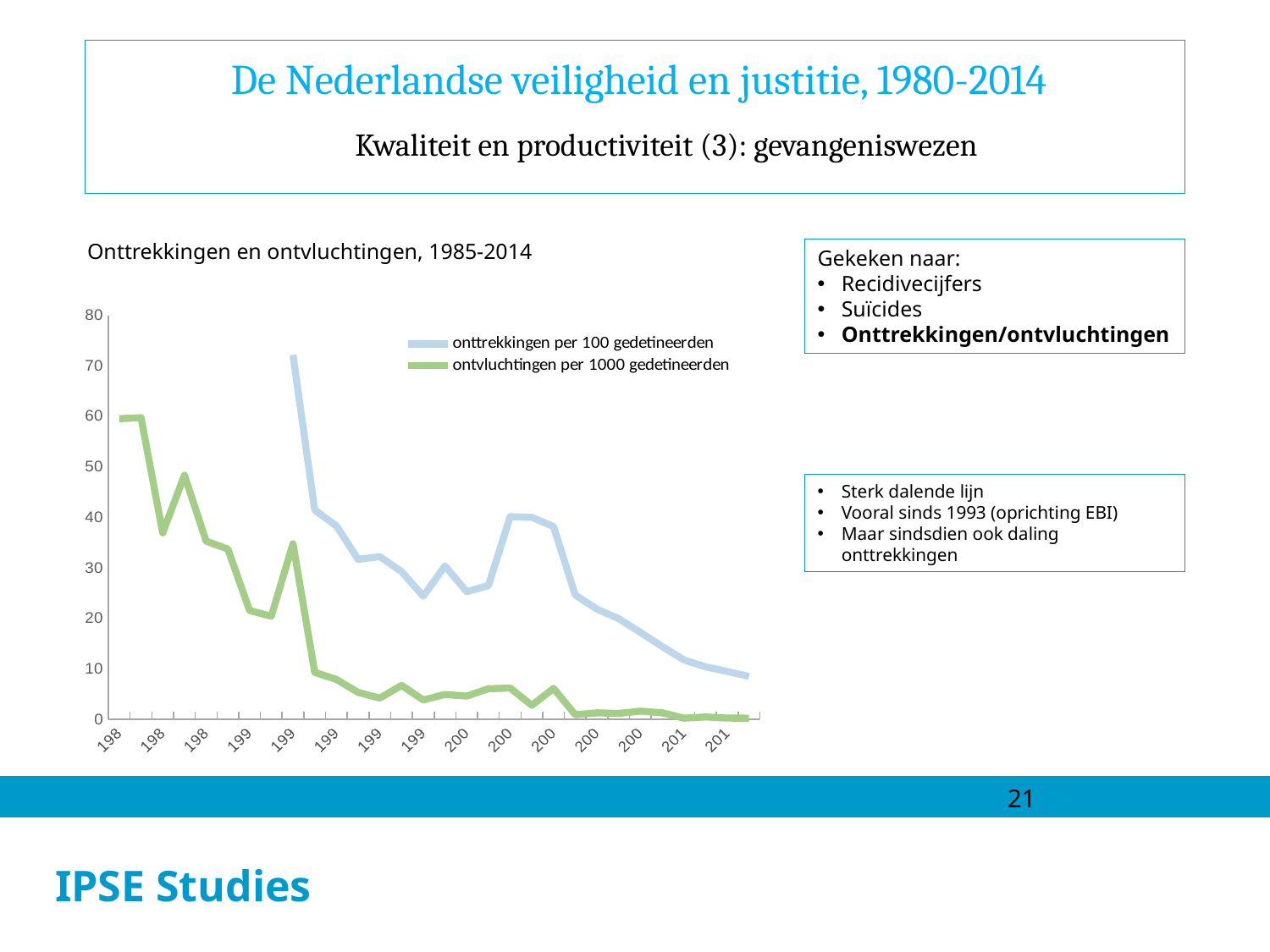
Is the last plotted value of the 'ontvluchtingen per 1000 gedetineerden' series greater or less than 10? less Which series is drawn in green in the chart? ontvluchtingen per 1000 gedetineerden Is the highest value of the 'onttrekkingen per 100 gedetineerden' series greater or less than 60? greater How many series does the chart's legend list? 2 Overall, do the values of the 'onttrekkingen per 100 gedetineerden' series rise or fall along the x axis? fall What is the title of the chart? Onttrekkingen en ontvluchtingen, 1985-2014 What kind of chart is shown on the slide? line chart Overall, do the values of the 'ontvluchtingen per 1000 gedetineerden' series rise or fall along the x axis? fall At the right end of the chart, which series has the higher value? onttrekkingen per 100 gedetineerden Is the highest value of the 'ontvluchtingen per 1000 gedetineerden' series greater or less than 50? greater Which series reaches the higher peak value in the chart? onttrekkingen per 100 gedetineerden